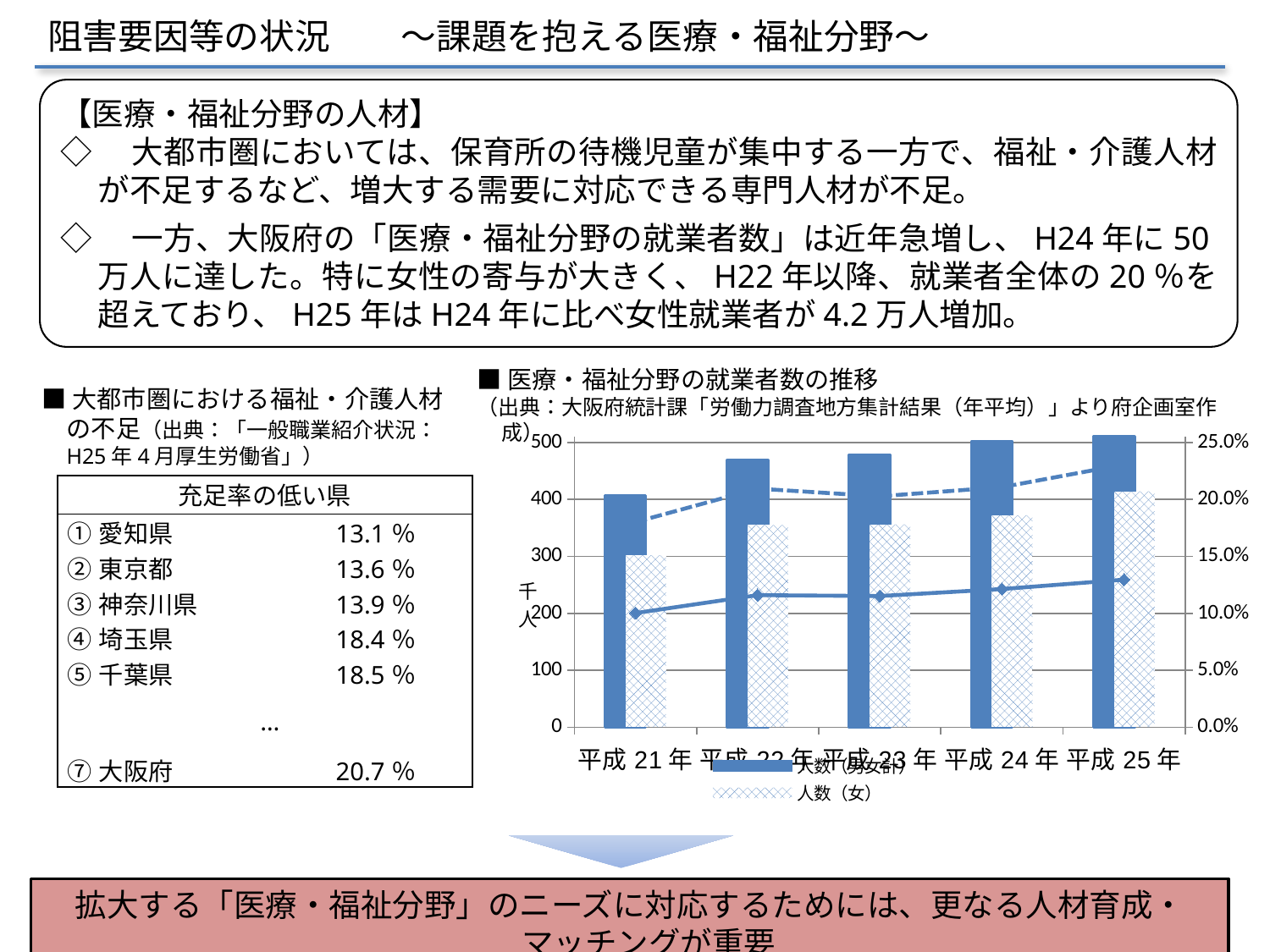
What kind of chart is shown on the slide? bar chart with line series Is the value for 人数（男女計） in 平成24年 greater or less than 400? greater Is the value for 人数（男女計） in 平成21年 greater or less than 500? less Which is larger, 人数（女） in 平成21年 or in 平成22年? 平成22年 Is the value for 人数（女） in 平成21年 greater or less than 400? less What unit is shown on the left vertical axis of the chart? 千人 Which year has the highest value for 人数（女）? 平成25年 How many years are shown on the x axis of the chart? 5 Which year has the lowest value for 人数（女）? 平成21年 Do the values for 人数（男女計） rise or fall from 平成21年 to 平成25年? rise Which year has the lowest value for 人数（男女計）? 平成21年